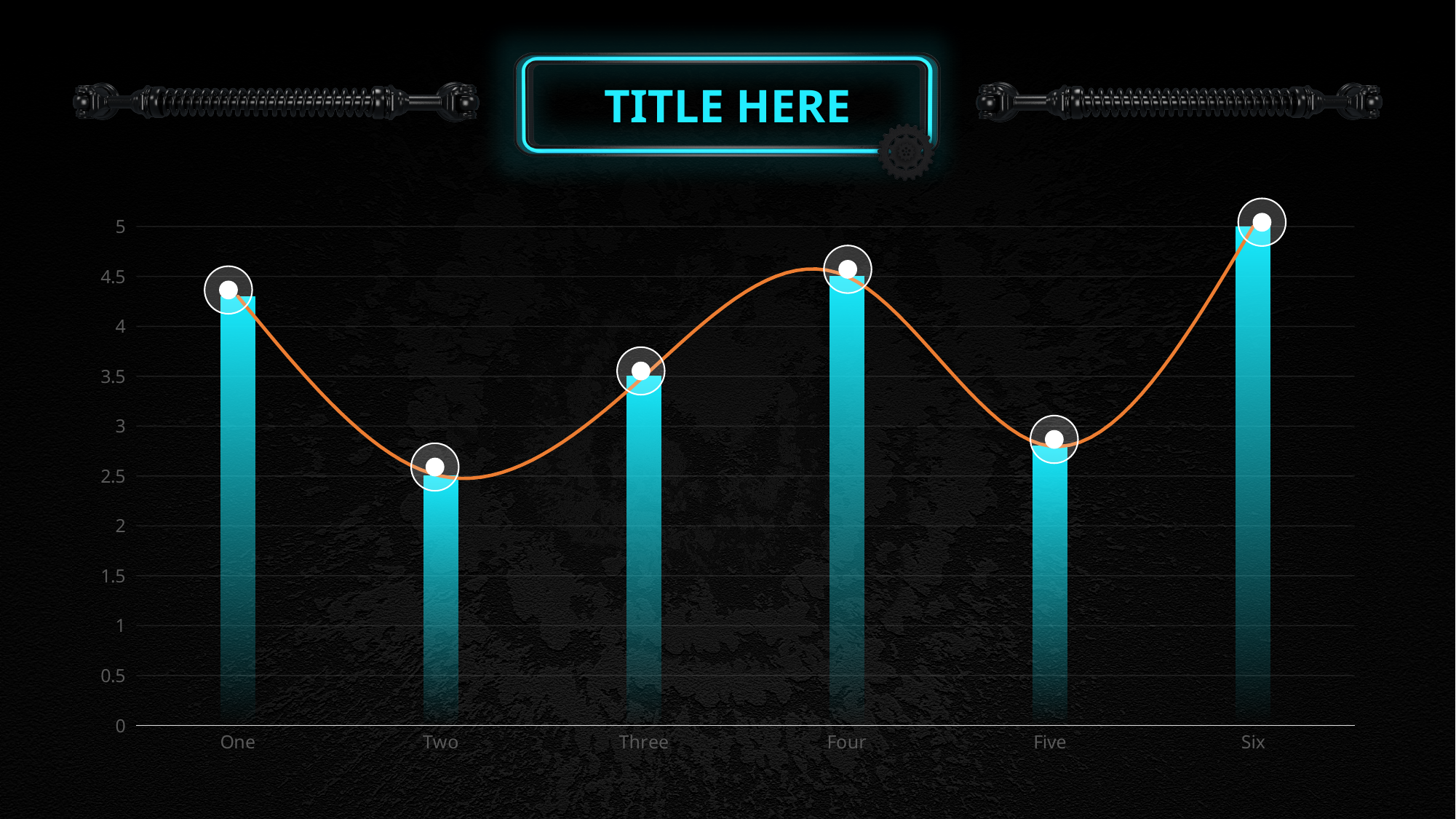
Is the value for Two greater or less than 3? less Is the value for Four greater or less than 4? greater Which is larger, the value for One or the value for Two? One Which category has the highest bar? Six What is the title shown above the chart? TITLE HERE Which category has the lowest bar? Two Is the value for One greater or less than 4? greater Which is larger, the value for Three or the value for Four? Four What kind of chart is shown on the slide? combination bar and line chart How many categories are shown on the x axis? 6